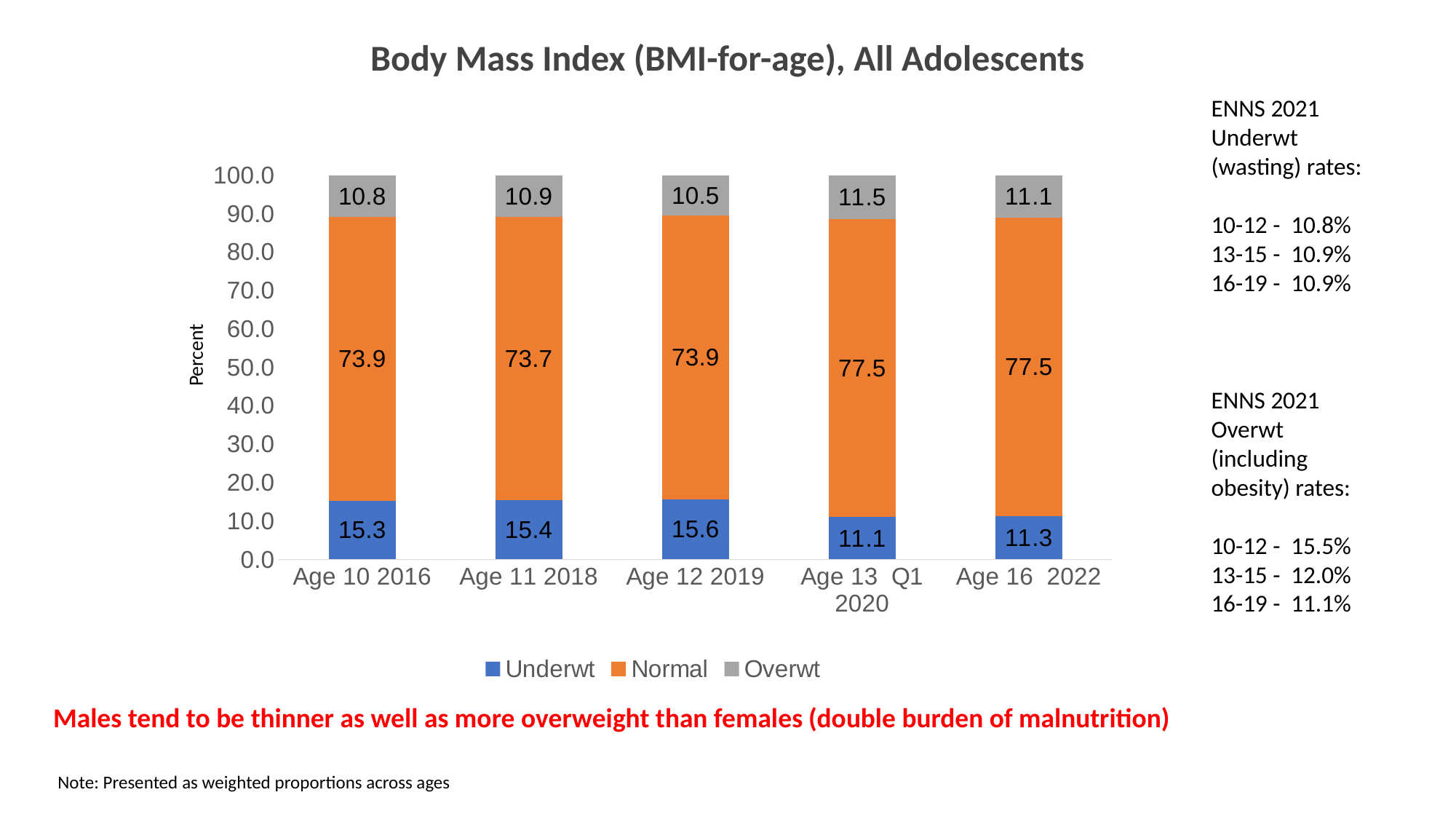
Which category has the highest Overwt value? Age 13 Q1 2020 What is the Normal value for Age 13 Q1 2020? 77.5 What kind of chart is shown? Stacked bar chart Is the Normal value larger for Age 11 2018 or Age 16 2022? Age 16 2022 How many categories are shown on the x axis? 5 What is the difference between the Underwt values for Age 12 2019 and Age 16 2022? 4.3 What is the Underwt value for Age 12 2019? 15.6 What is the title of the chart? Body Mass Index (BMI-for-age), All Adolescents Which category has the lowest Underwt value? Age 13 Q1 2020 How many series does the legend list? 3 What is the Overwt value for Age 10 2016? 10.8 What is the total of the stacked bar for Age 11 2018? 100.0